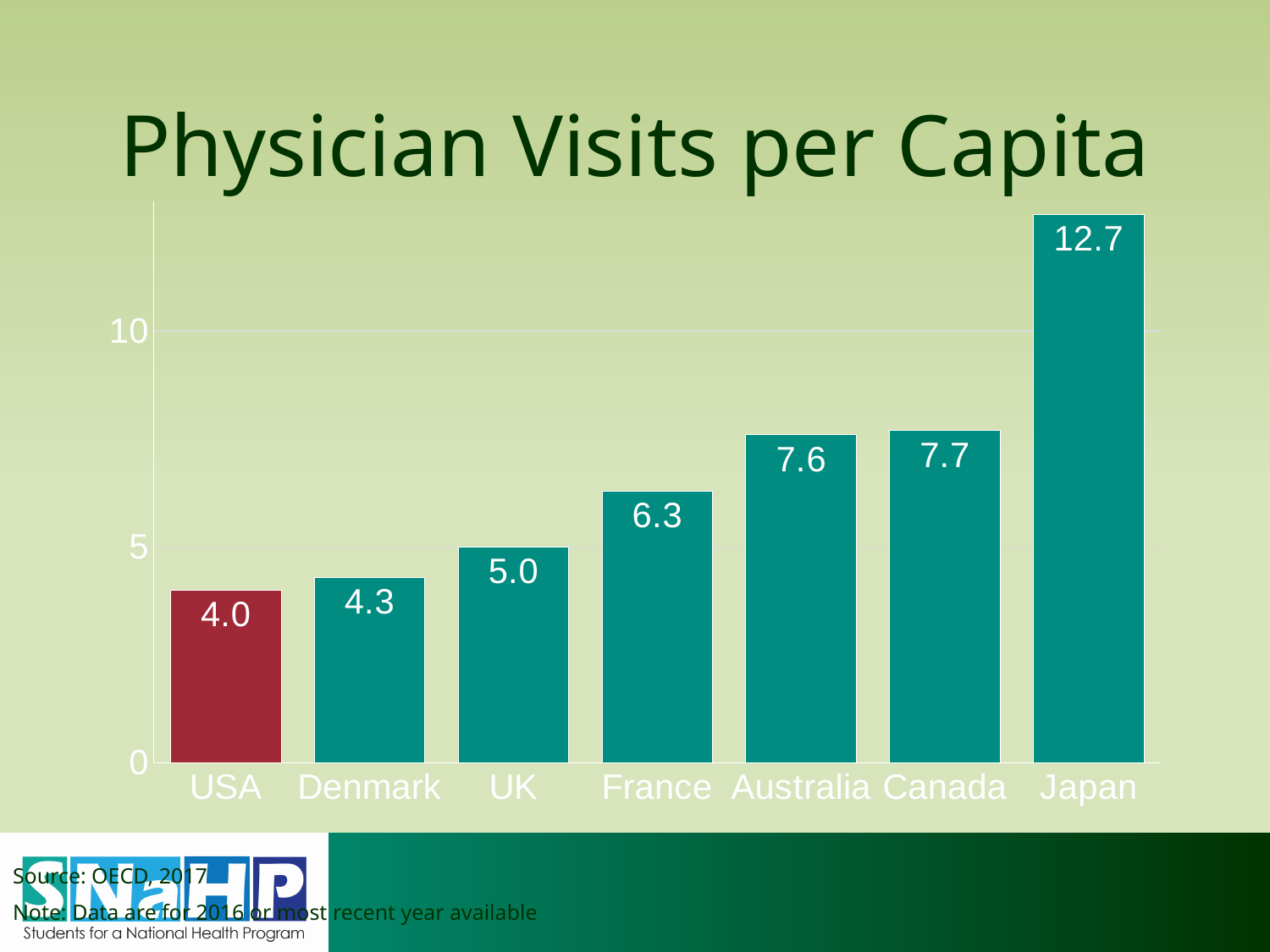
Which country has the lowest number of physician visits per capita? USA What kind of chart is shown on the slide? bar chart Is the value for Australia greater or less than 5? greater Which country has the highest number of physician visits per capita? Japan What is the difference between the values for Canada and Denmark? 3.4 What is the value for Japan? 12.7 What is the value for France? 6.3 What is the value for the USA? 4.0 What is the difference between the values for Japan and the USA? 8.7 Which is larger, the value for France or the value for UK? France How many countries are shown in the chart? 7 Which bar is coloured differently from the others? USA